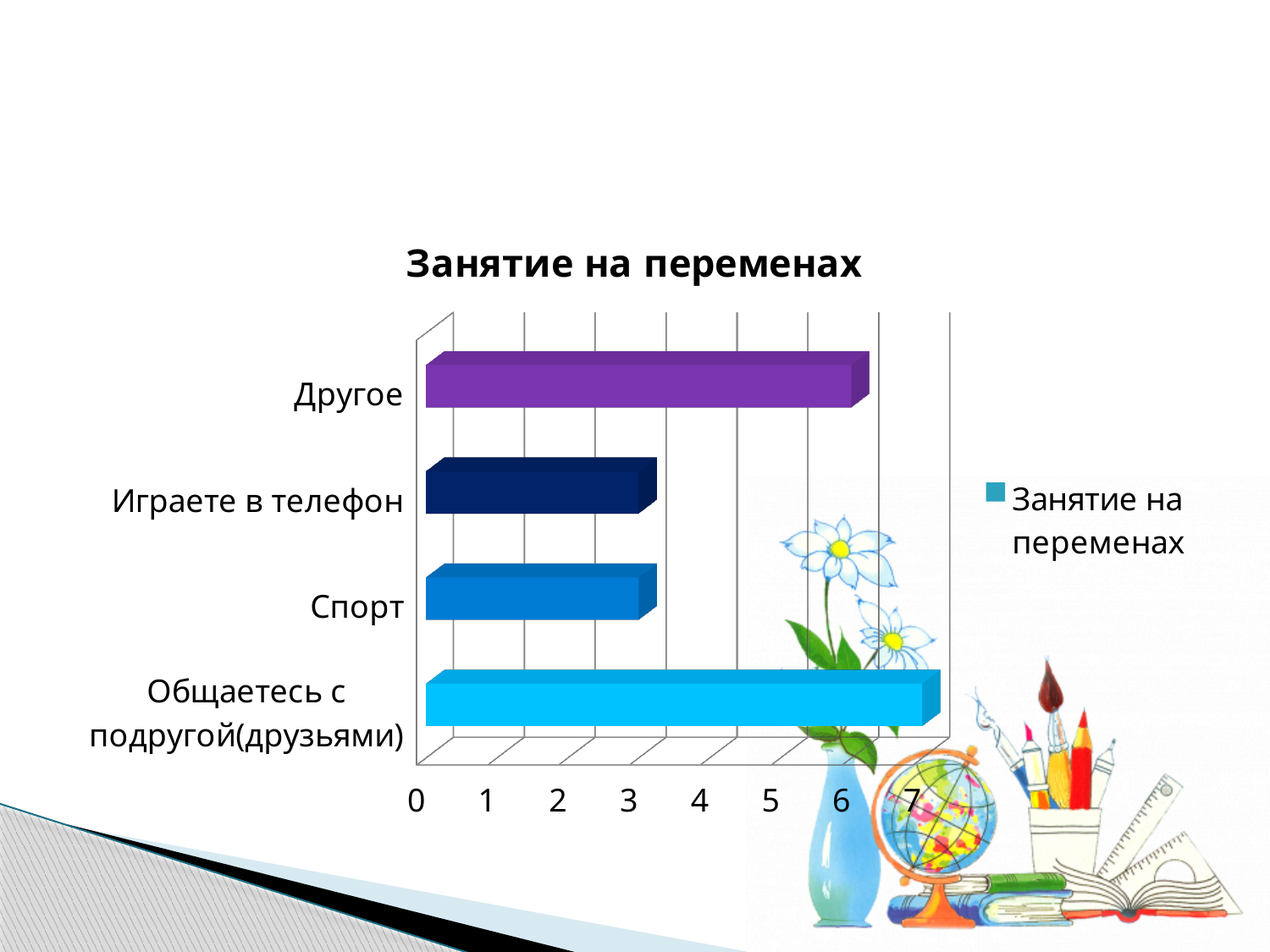
Is the value for Спорт greater or less than 4? less Is the value for Играете в телефон greater or less than 4? less How many series does the legend list? 1 Which category has the highest value? Общаетесь с подругой(друзьями) Is the value for Другое greater or less than 5? greater What is the legend entry shown next to the chart? Занятие на переменах How many categories are shown in the chart? 4 Which is larger, the value for Другое or the value for Спорт? Другое What kind of chart is shown on the slide? bar chart Which is larger, the value for Общаетесь с подругой(друзьями) or the value for Играете в телефон? Общаетесь с подругой(друзьями) What is the title of the chart? Занятие на переменах